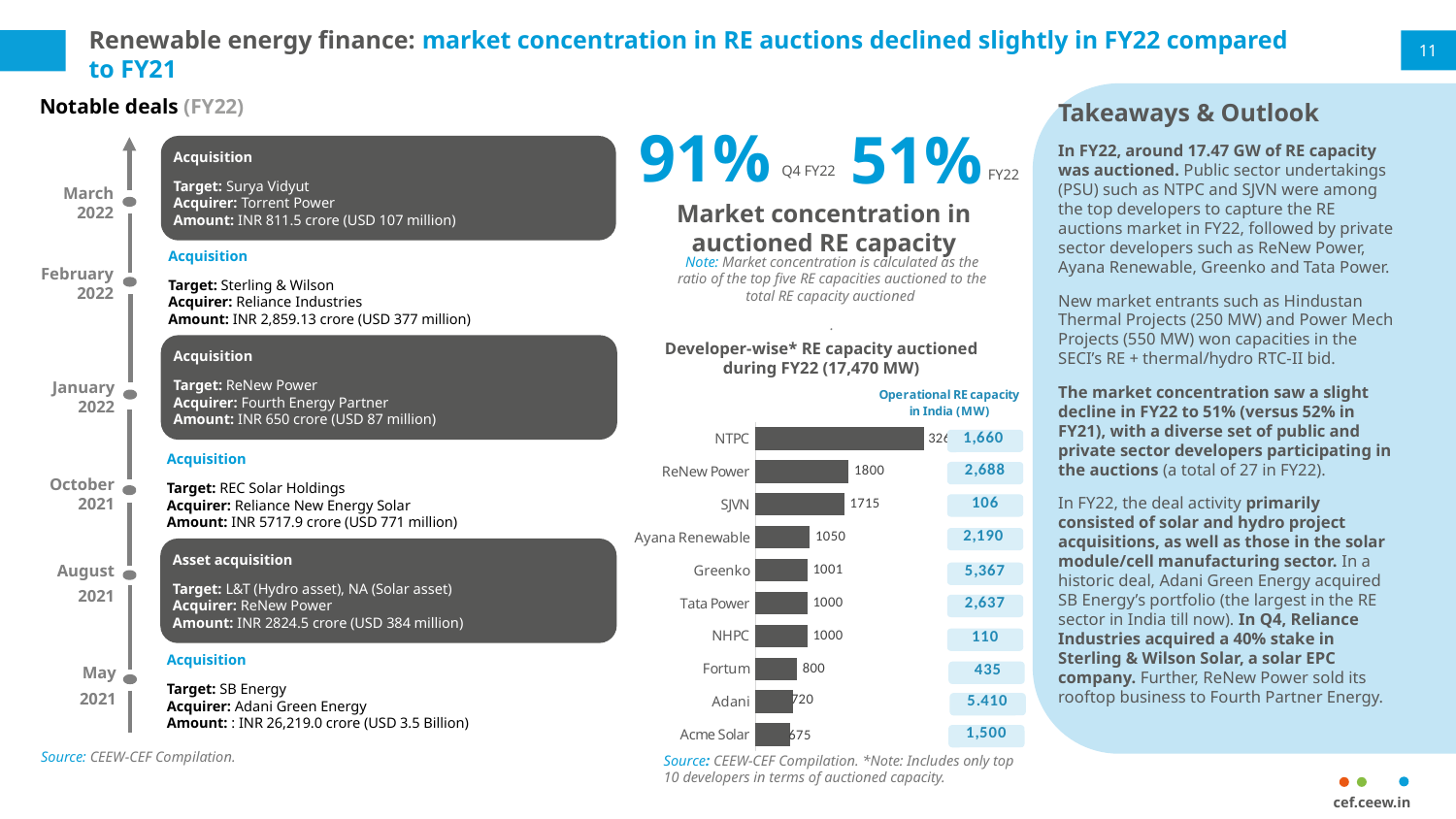
What is the difference between the RE capacity auctioned for ReNew Power and SJVN in the chart? 85 Which developer has the largest RE capacity auctioned during FY22 in the chart? NTPC What is the RE capacity auctioned during FY22 for Fortum in the chart? 800 What kind of chart is used to show developer-wise RE capacity auctioned during FY22? bar chart What is the RE capacity auctioned during FY22 for ReNew Power in the chart? 1800 Which developer has the smallest RE capacity auctioned during FY22 in the chart? Acme Solar What is the RE capacity auctioned during FY22 for SJVN in the chart? 1715 How many developers are shown in the developer-wise RE capacity auctioned chart? 10 What is the RE capacity auctioned during FY22 for Greenko in the chart? 1001 What total RE capacity auctioned during FY22 is stated in the chart title? 17,470 MW In the developer-wise chart, which has a larger RE capacity auctioned: Ayana Renewable or Adani? Ayana Renewable What is the difference between the RE capacity auctioned for Adani and Acme Solar in the chart? 45